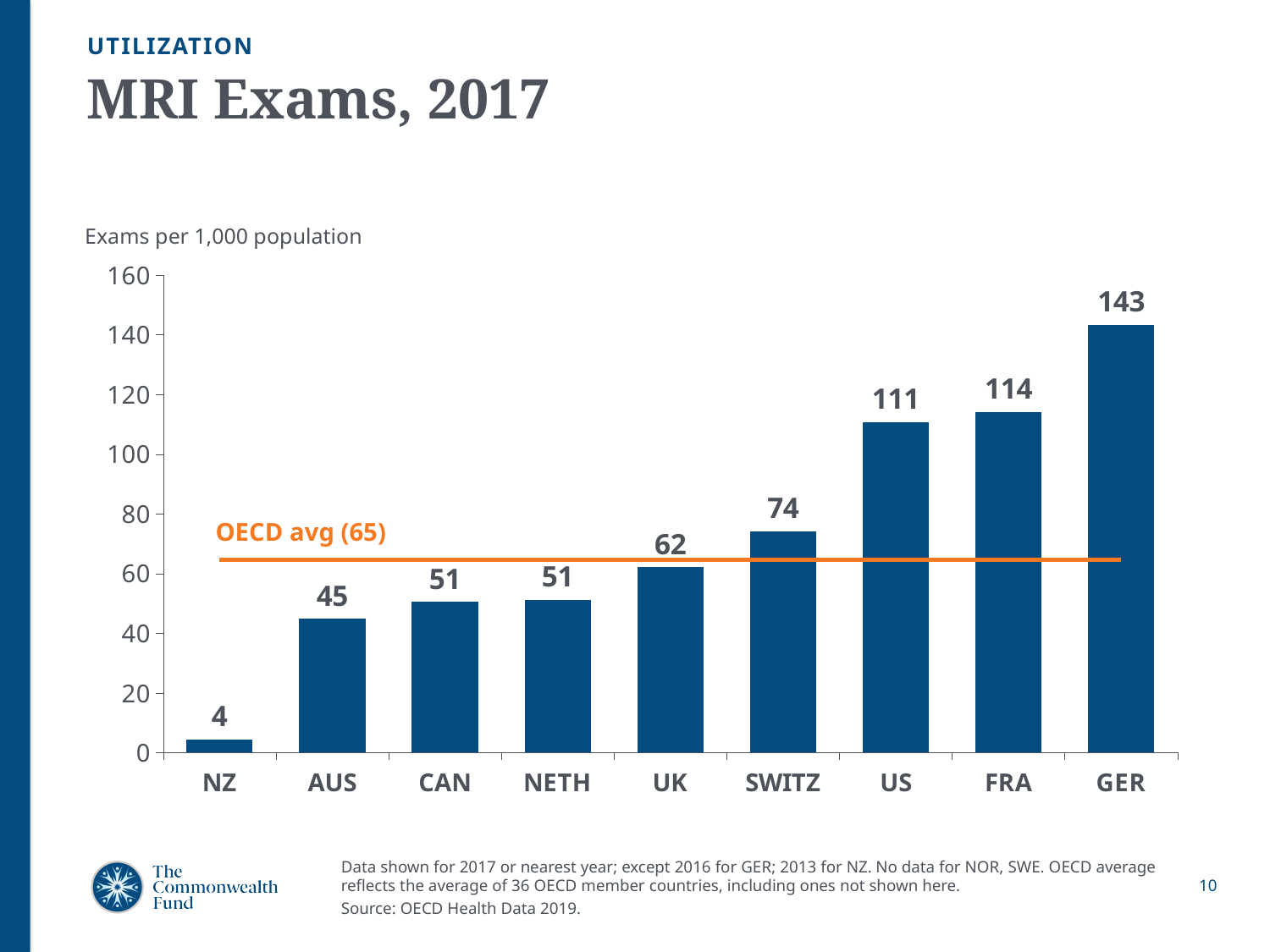
How many countries are shown on the chart? 9 Which country has the lowest number of MRI exams per 1,000 population? NZ What is the value for NZ? 4 What is the OECD average shown on the chart? 65 Which country has the highest number of MRI exams per 1,000 population? GER What is the value for GER? 143 Which is larger, the value for FRA or the value for US? FRA What is the difference between the values for UK and AUS? 17 What is the value for SWITZ? 74 What kind of chart is shown on the slide? bar chart Is the value for SWITZ greater or less than 80? less What is the difference between the values for GER and US? 32